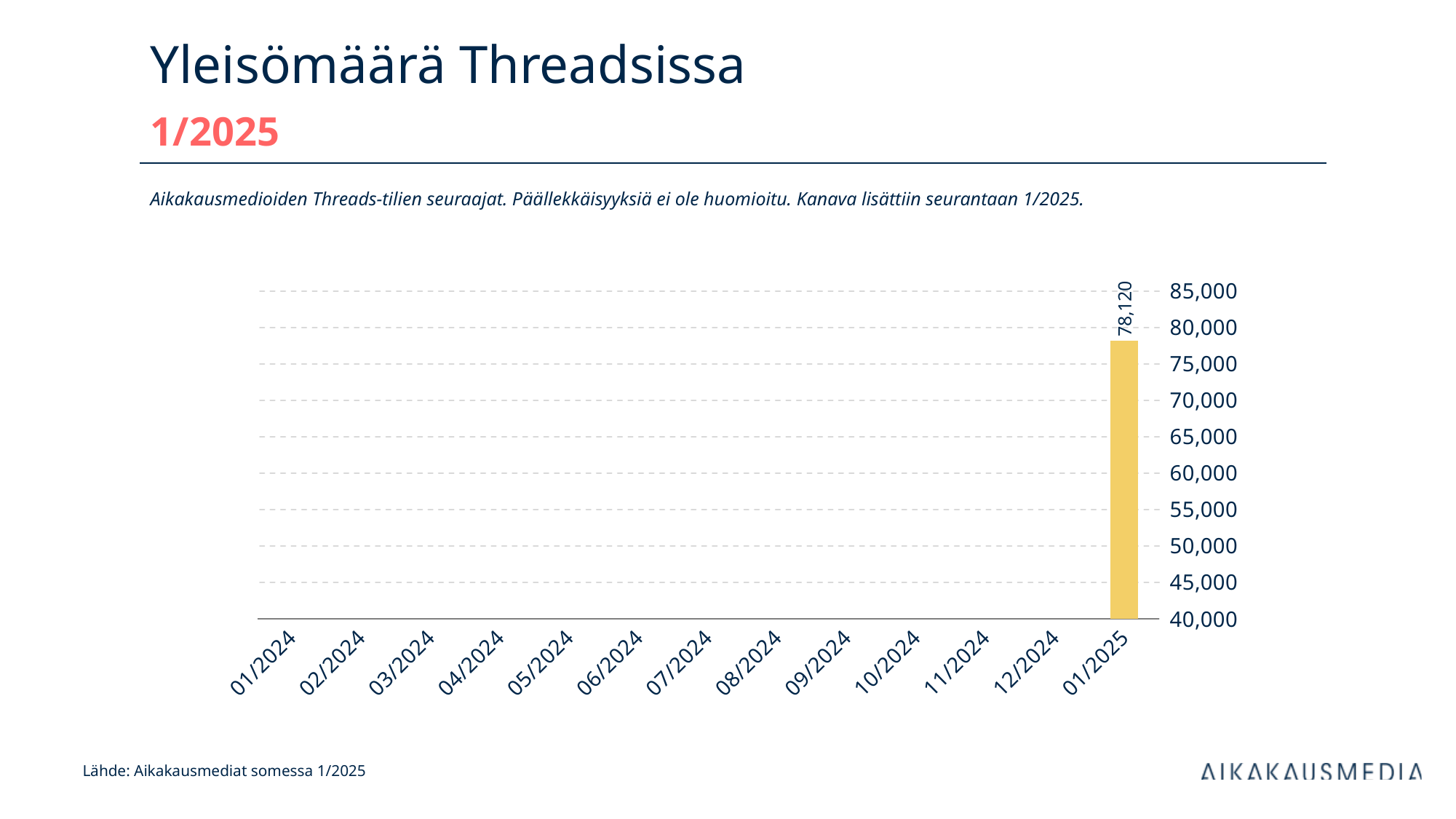
How many bars are plotted in the chart? 1 Which category has a bar plotted? 01/2025 What is the lowest value shown on the y axis? 40,000 Is the value for 01/2025 greater or less than 75,000? greater How many categories are shown on the x axis? 13 What is the first category on the x axis? 01/2024 Is the value for 01/2025 greater or less than 80,000? less What kind of chart is shown on the slide? bar chart What is the value shown for 01/2025? 78,120